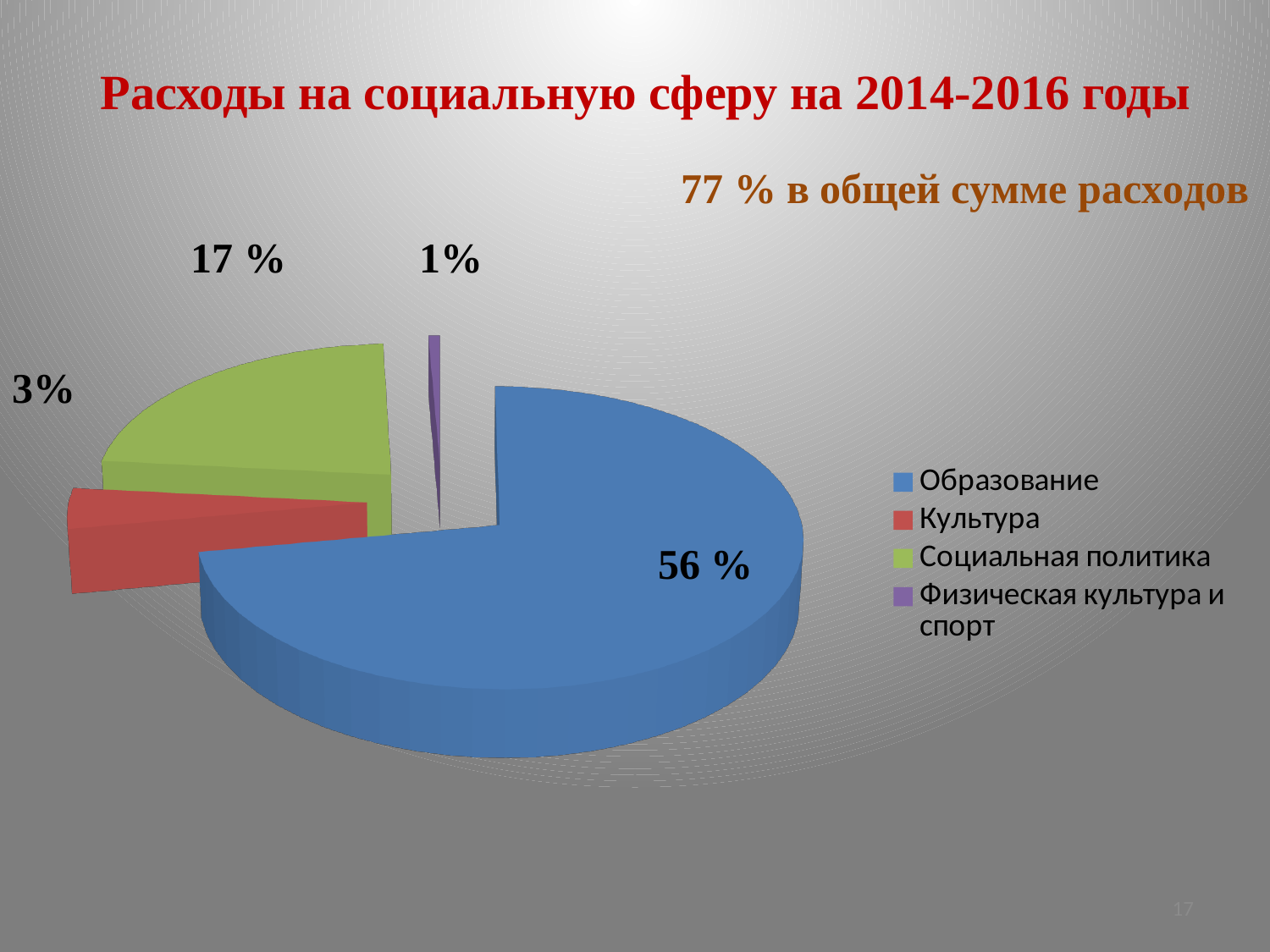
What colour is the slice for Социальная политика? green Which category has the smallest slice of the pie? Физическая культура и спорт What share of the pie does Культура have? 3% What share of the pie does Физическая культура и спорт have? 1% What is the title of the chart on the slide? Расходы на социальную сферу на 2014-2016 годы Which category has the largest slice of the pie? Образование What share of the pie does Социальная политика have? 17 % What is the difference in percentage points between Образование and Социальная политика? 39 How many categories does the pie chart show? 4 What kind of chart is shown on the slide? pie chart Which is larger, the slice for Культура or the slice for Социальная политика? Социальная политика What share of the pie does Образование have? 56 %